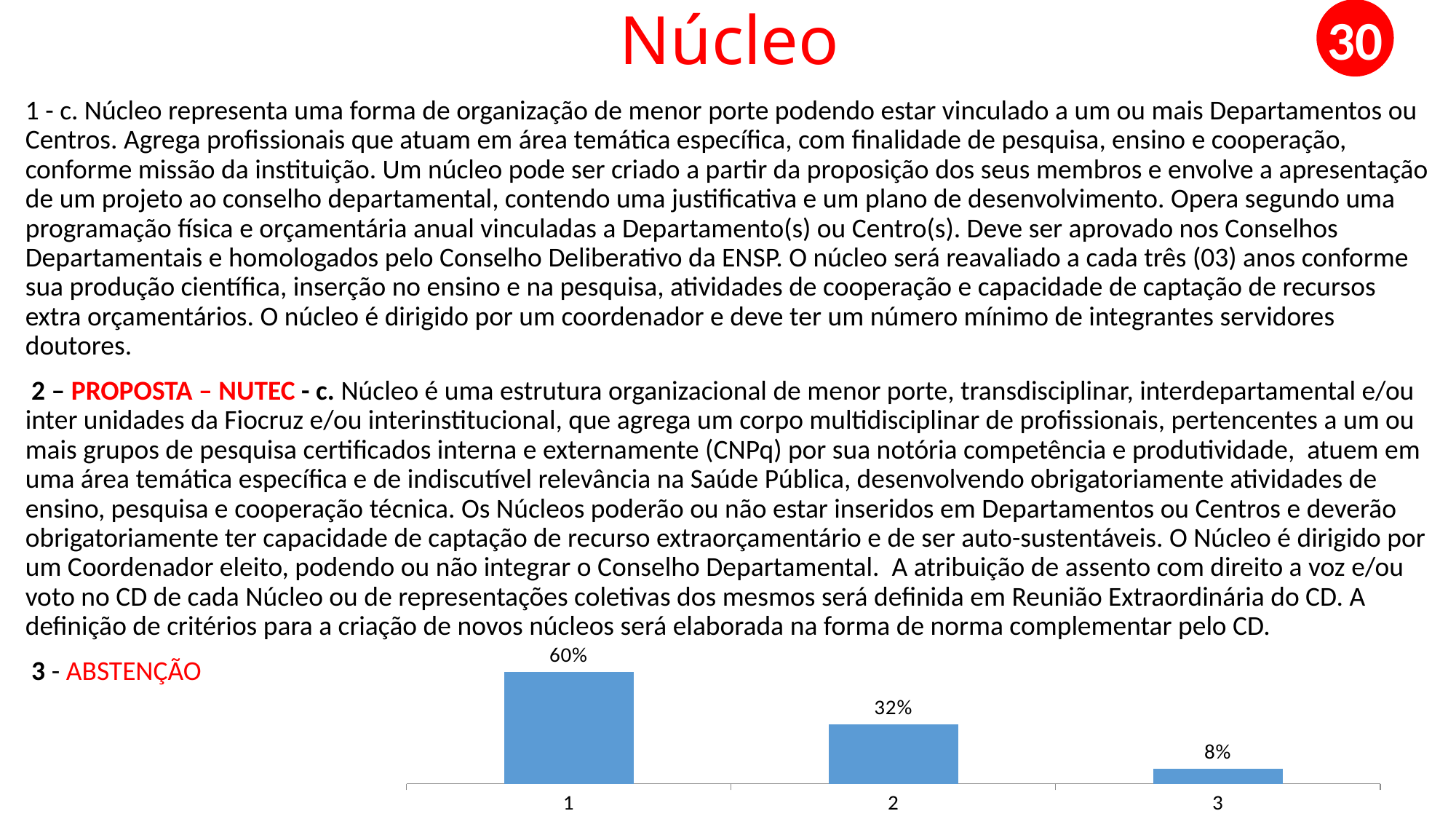
What kind of chart is shown on the slide? bar chart How many categories are shown in the bar chart? 3 What is the value for category 1 in the bar chart? 60% Do the values rise or fall from category 1 to category 3? fall What is the difference between the values for category 1 and category 2? 28% Which category has the lowest value in the bar chart? 3 What colour are the bars in the chart? blue What is the value for category 3 in the bar chart? 8% What is the difference between the values for category 2 and category 3? 24% Which is larger, the value for category 2 or the value for category 3? 2 Which category has the highest value in the bar chart? 1 What is the value for category 2 in the bar chart? 32%